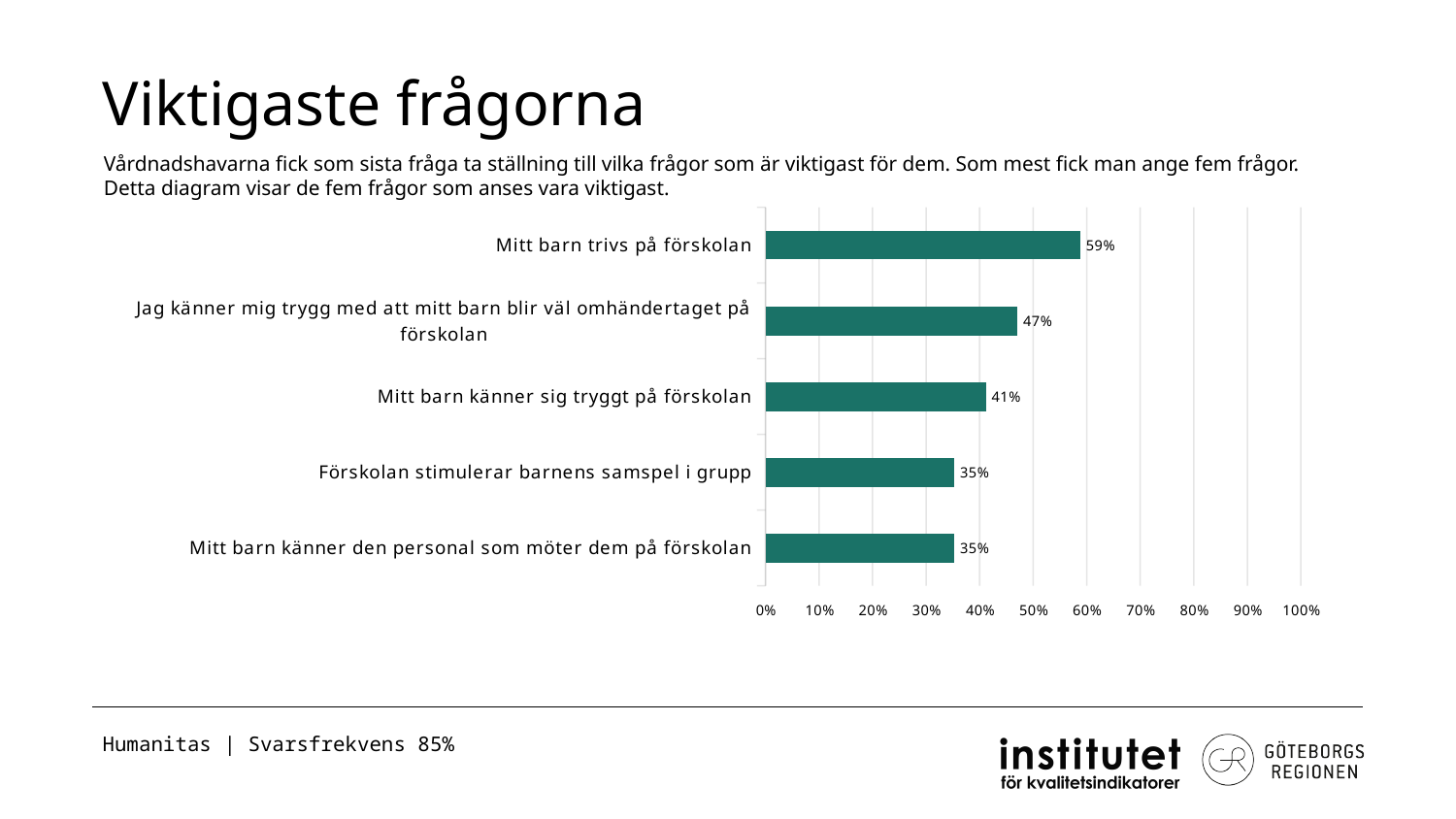
What is the value for "Mitt barn känner sig tryggt på förskolan"? 41% How many categories are shown in the chart? 5 What is the difference between the values for "Mitt barn trivs på förskolan" and "Mitt barn känner sig tryggt på förskolan"? 18% What kind of chart is shown on the slide? bar chart Which is larger: the value for "Jag känner mig trygg med att mitt barn blir väl omhändertaget på förskolan" or the value for "Mitt barn känner sig tryggt på förskolan"? Jag känner mig trygg med att mitt barn blir väl omhändertaget på förskolan Which category has the highest value? Mitt barn trivs på förskolan What is the difference between the values for "Jag känner mig trygg med att mitt barn blir väl omhändertaget på förskolan" and "Förskolan stimulerar barnens samspel i grupp"? 12% What is the value for "Jag känner mig trygg med att mitt barn blir väl omhändertaget på förskolan"? 47% What is the value for "Mitt barn trivs på förskolan"? 59% Is the value for "Mitt barn trivs på förskolan" greater or less than 50%? greater What is the title of the slide containing the chart? Viktigaste frågorna What is the value for "Förskolan stimulerar barnens samspel i grupp"? 35%